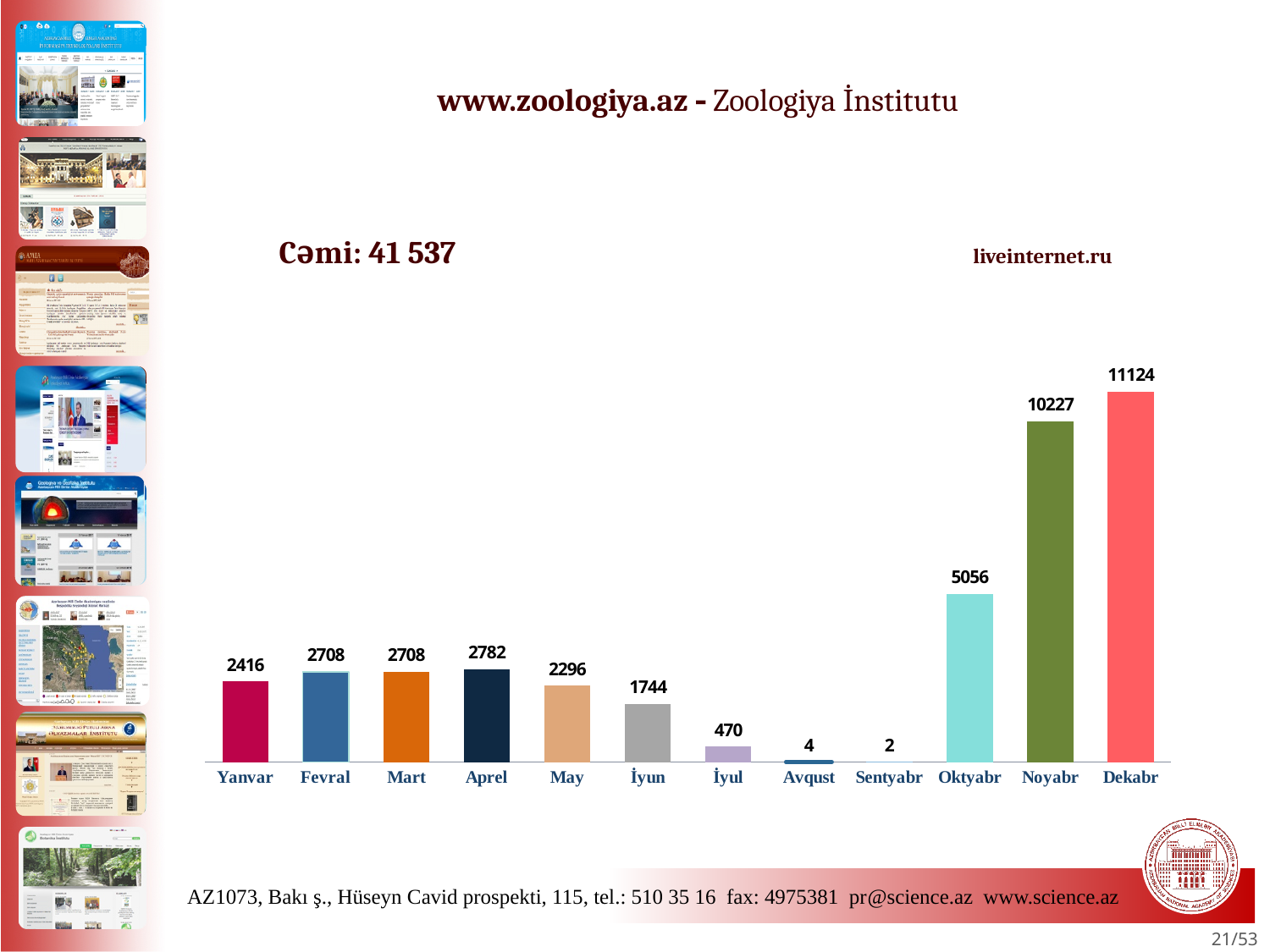
What is the value for Oktyabr? 5056 What total (Cəmi) is stated on the slide? 41 537 What is the value for İyul? 470 Which is larger, the value for Yanvar or the value for May? Yanvar What kind of chart is shown on the slide? Bar chart What is the difference between the values for Aprel and May? 486 Which month has the lowest value? Sentyabr Do the values rise or fall from Oktyabr to Dekabr? Rise How many months are shown on the chart? 12 Which month has the highest value? Dekabr What is the difference between the values for Dekabr and Noyabr? 897 What is the value for Dekabr? 11124